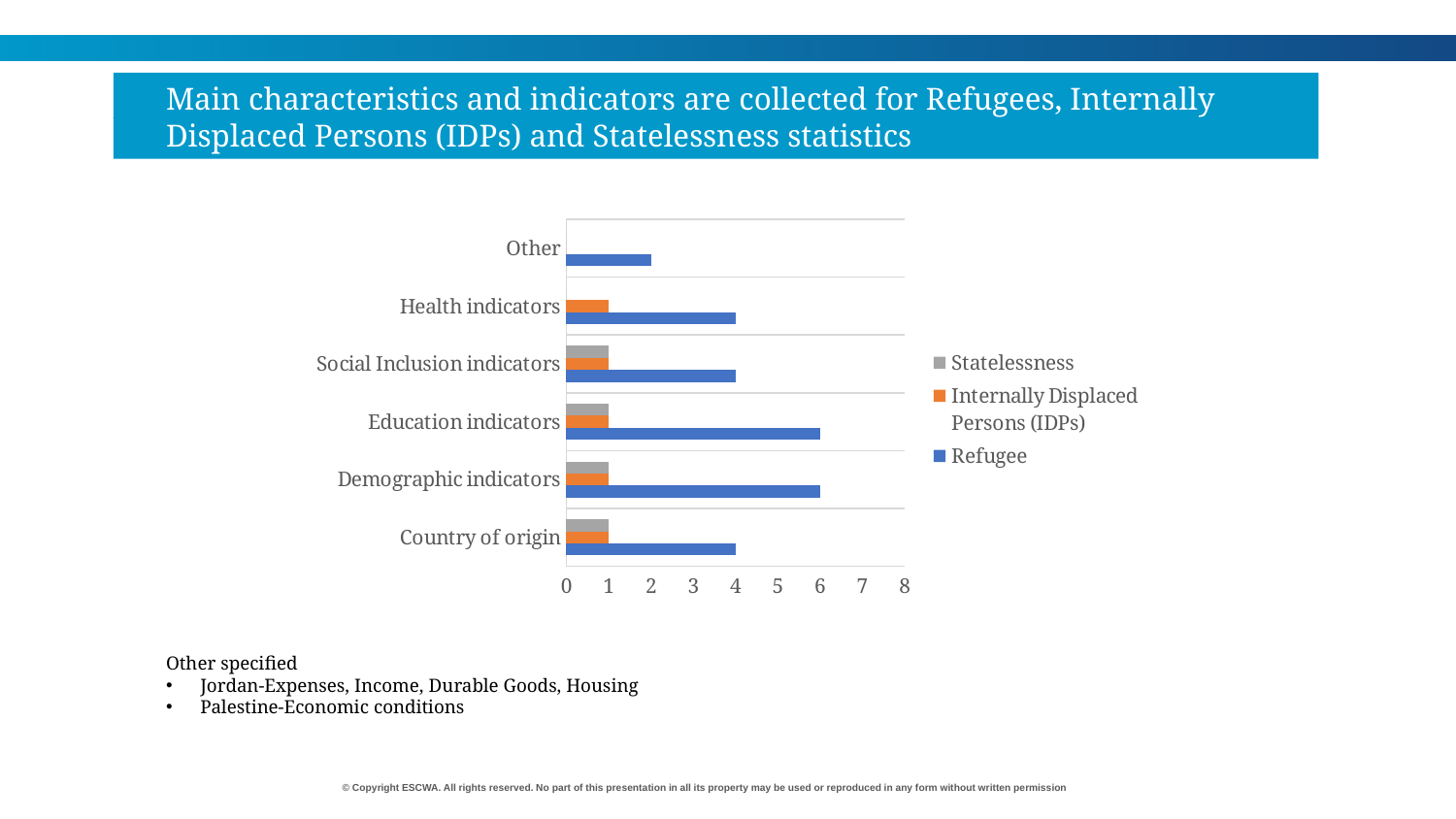
Which is larger, the Refugee value for Education indicators or the Refugee value for Country of origin? Education indicators What is the Refugee value for Education indicators? 6 How many series does the legend list? 3 What is the Refugee value for Other? 2 What is the difference between the Refugee values for Demographic indicators and Health indicators? 2 What is the Refugee value for Health indicators? 4 What kind of chart is shown on the slide? bar chart Which category has the lowest Refugee value? Other Is the Refugee value for Demographic indicators greater or less than 5? greater What is the Internally Displaced Persons (IDPs) value for Country of origin? 1 Which series is shown in blue in the legend? Refugee How many categories are shown on the vertical axis of the chart? 6